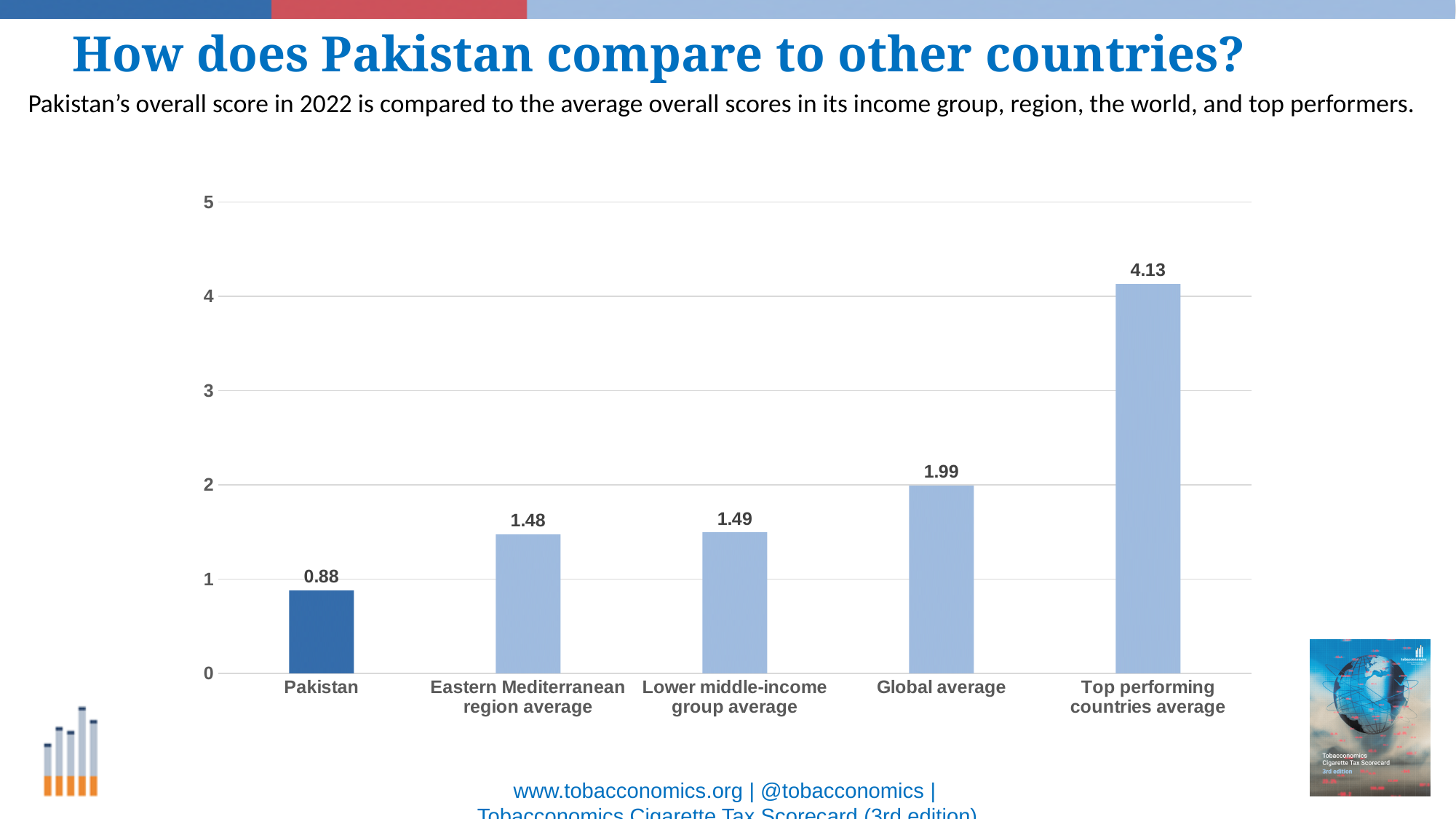
How many categories are shown on the chart? 5 What is the value for Top performing countries average? 4.13 Which category has the lowest value? Pakistan What is the value for Eastern Mediterranean region average? 1.48 What is the difference between the Top performing countries average and Pakistan? 3.25 Is the value for Top performing countries average greater or less than 4? greater Which category has the highest value? Top performing countries average What kind of chart is shown on the slide? Bar chart What is the value for Pakistan? 0.88 Which is larger, the Global average or the Lower middle-income group average? Global average What is the value for Global average? 1.99 What is the difference between the Global average and Pakistan? 1.11